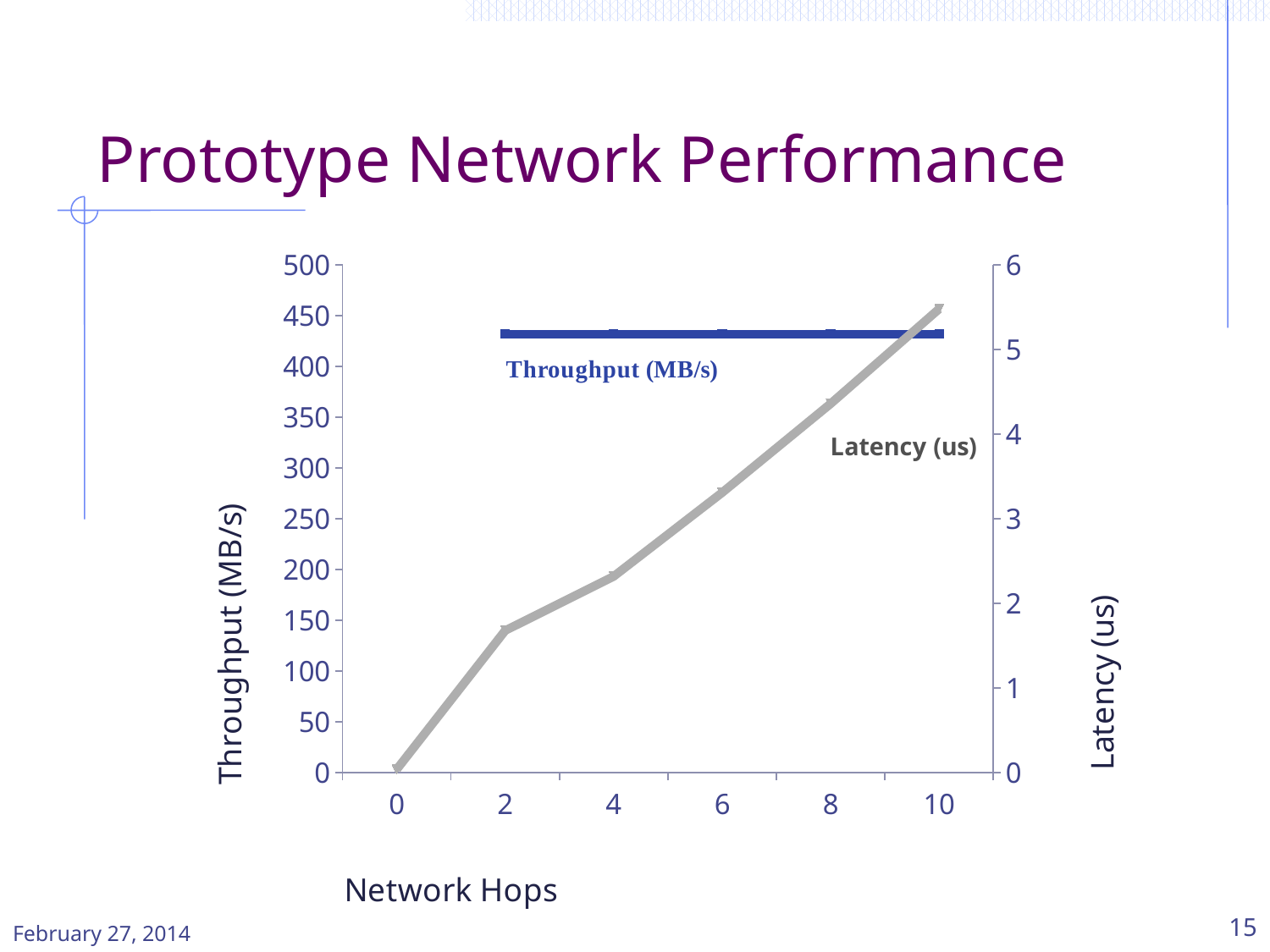
Which has the larger Latency (us) value: 2 Network Hops or 10 Network Hops? 10 Network Hops Is the Latency (us) value at 10 Network Hops greater or less than 5? greater Does the Throughput (MB/s) series rise, fall, or stay roughly flat as Network Hops increase from 2 to 10? stay roughly flat Does the Latency (us) series rise or fall as Network Hops increase? rise Is the Throughput (MB/s) value at 6 Network Hops greater or less than 400? greater How many data series are plotted on the chart? 2 What kind of chart is shown on the slide? line chart What is the label of the x axis? Network Hops What is the title of the chart on the slide? Prototype Network Performance Is the Latency (us) value at 2 Network Hops greater or less than 2? less How many tick labels are shown on the Network Hops axis? 6